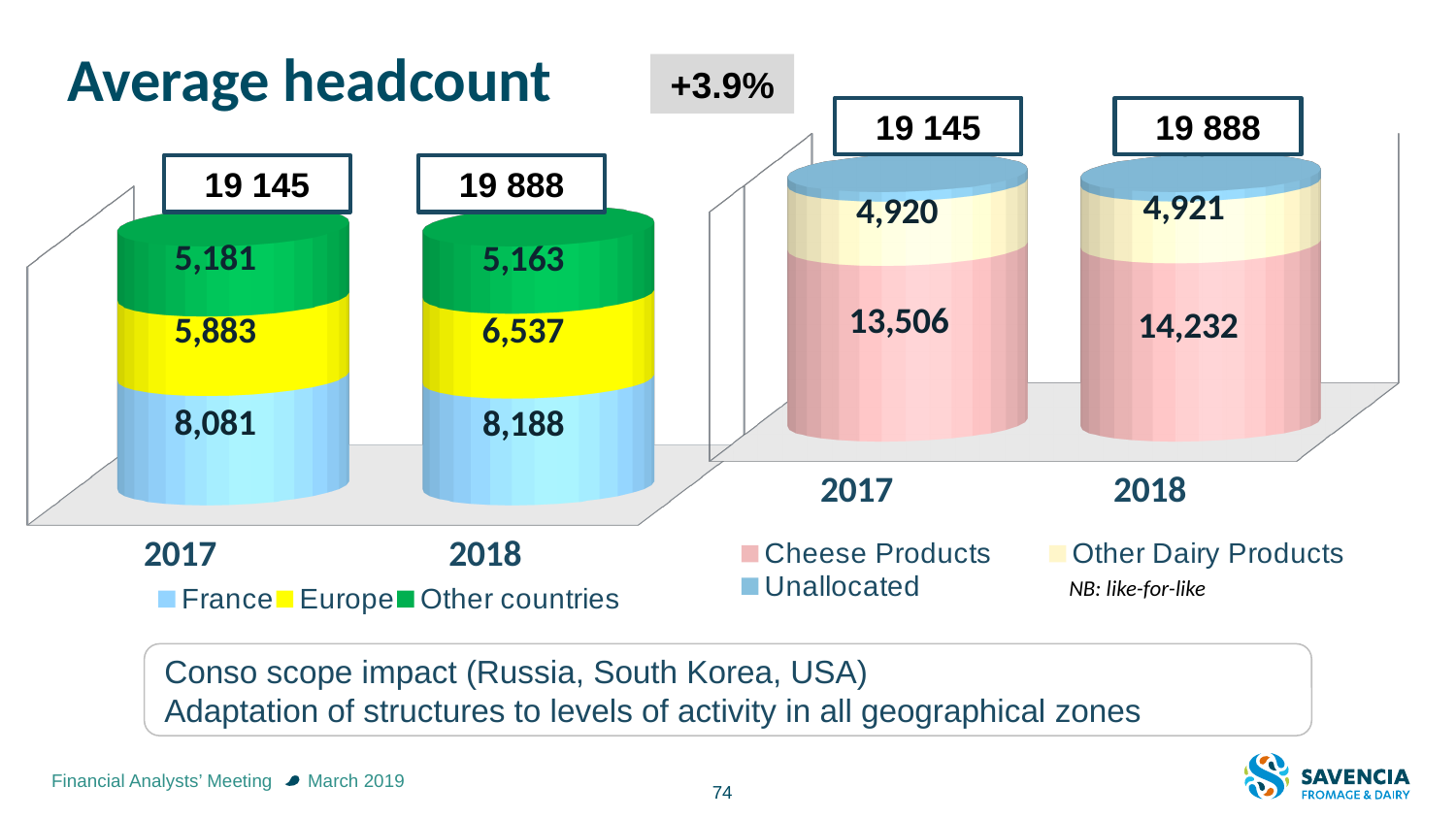
In the left chart (by geography), which region has the smallest headcount in 2018? Other countries In the left chart (by geography), what is the value for France in 2018? 8,188 In the left chart (by geography), what is the total headcount shown for 2018? 19 888 In the left chart (by geography), what is the difference between the Europe values for 2018 and 2017? 654 How many series does the legend of the right chart (by product) list? 3 In the right chart (by product), what is the difference between the Cheese Products values for 2018 and 2017? 726 In the left chart (by geography), which region has the largest headcount in 2017? France In the left chart (by geography), what is the value for Europe in 2017? 5,883 In the right chart (by product), what is the value for Other Dairy Products in 2017? 4,920 What percentage change in average headcount is shown at the top of the slide? +3.9% In the right chart (by product), what is the value for Cheese Products in 2018? 14,232 In the left chart (by geography), is the Other countries value larger in 2017 or in 2018? 2017